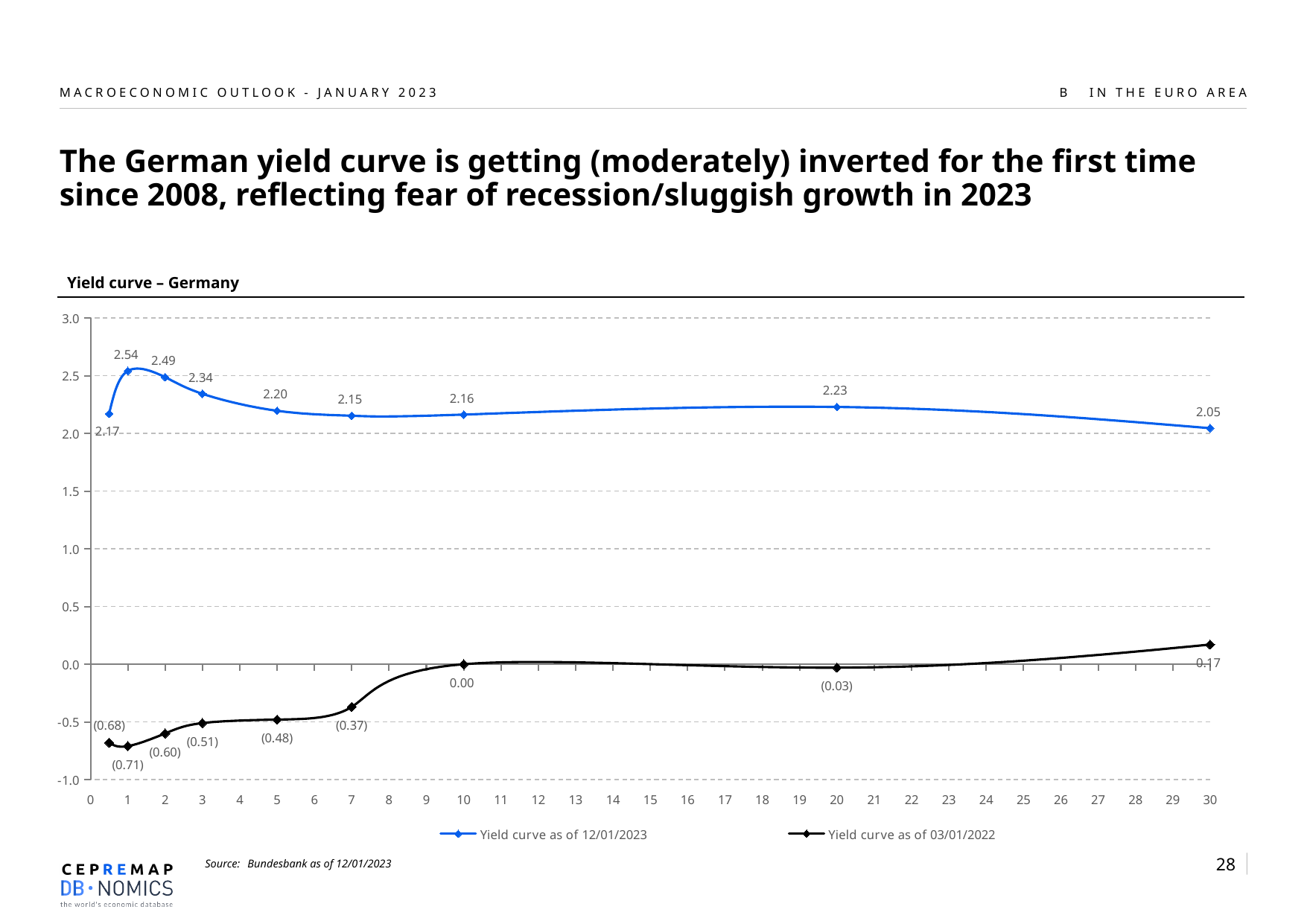
What is the value of the yield curve as of 12/01/2023 at a maturity of 30? 2.05 What is the title of the chart? Yield curve – Germany At which maturity does the yield curve as of 12/01/2023 reach its lowest value? 30 At a maturity of 20, which series has the higher value: the yield curve as of 12/01/2023 or as of 03/01/2022? Yield curve as of 12/01/2023 How many series does the legend list? 2 What is the difference between the yield curve as of 12/01/2023 at maturity 1 and at maturity 30? 0.49 What is the value of the yield curve as of 12/01/2023 at a maturity of 1? 2.54 What is the value of the yield curve as of 03/01/2022 at a maturity of 10? 0.00 At which maturity does the yield curve as of 12/01/2023 reach its highest value? 1 What is the value of the yield curve as of 03/01/2022 at a maturity of 7? (0.37) How many data points are plotted for the yield curve as of 12/01/2023? 9 What kind of chart is shown on the slide? line chart